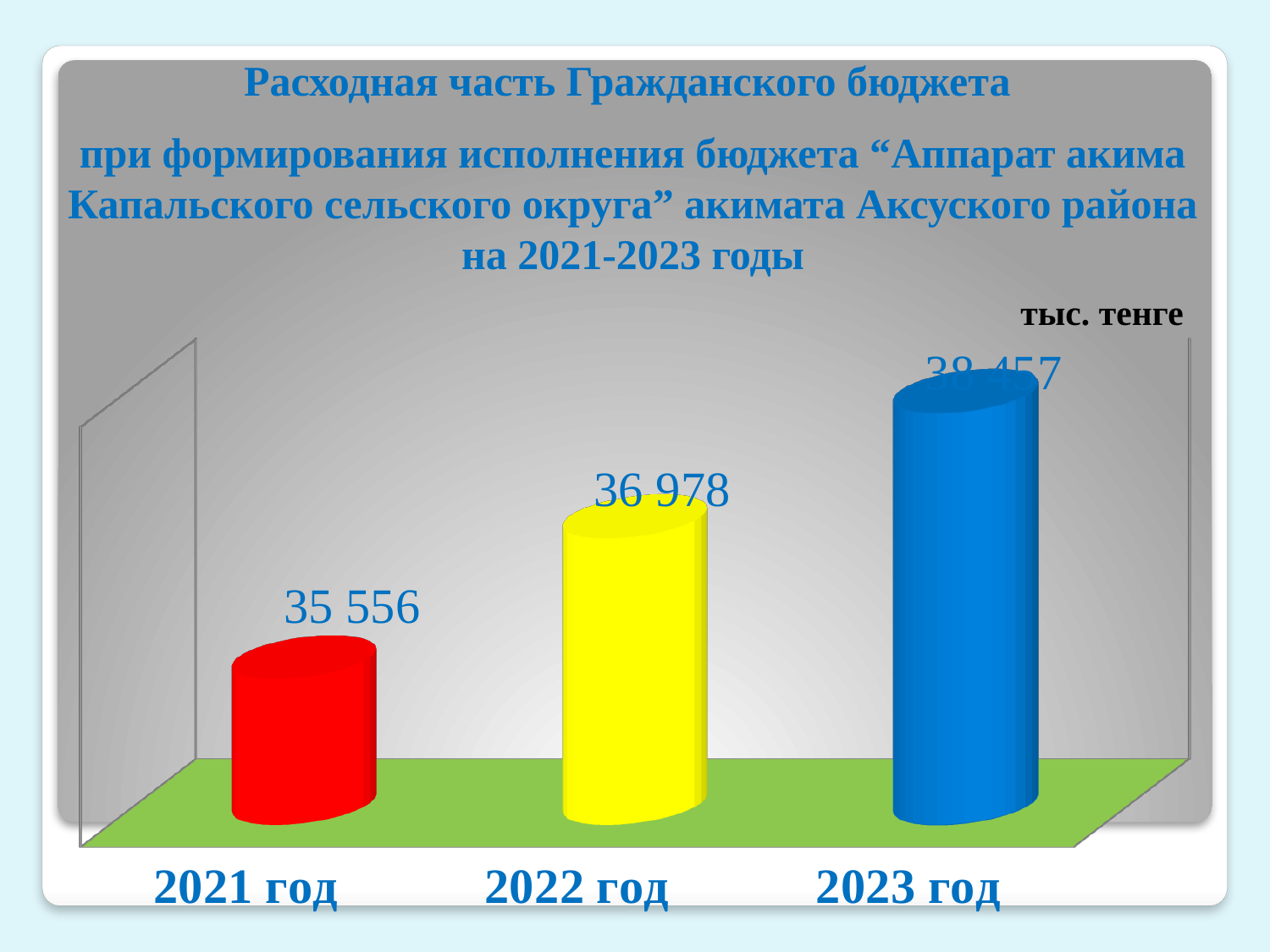
Which is larger, the value for 2022 год or the value for 2021 год? 2022 год Which year has the lowest value? 2021 год What is the difference between the values for 2023 год and 2022 год? 1 479 What is the value for 2023 год? 38 457 Which year has the highest value? 2023 год What kind of chart is shown on the slide? bar chart What is the difference between the values for 2022 год and 2021 год? 1 422 What is the value for 2022 год? 36 978 Do the values rise or fall from 2021 год to 2023 год? rise How many years are shown in the chart? 3 What unit is indicated for the values in the chart? тыс. тенге What is the value for 2021 год? 35 556